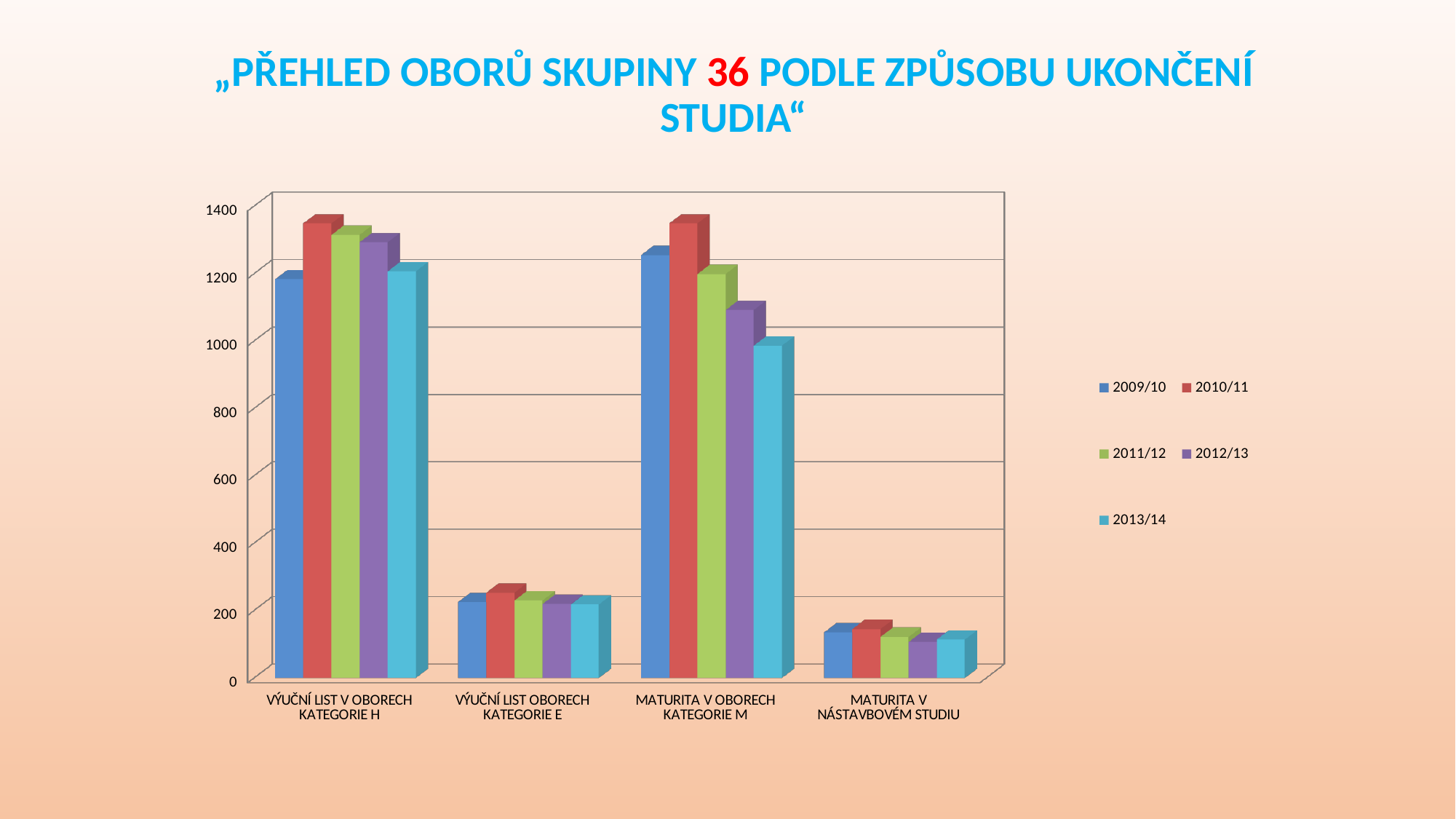
Within the category Maturita v oborech kategorie M, which series has the lowest value? 2013/14 Which category has the lowest values across all series? Maturita v nástavbovém studiu Is the value for 2012/13 in Maturita v oborech kategorie M greater or less than 1000? greater Is the value for 2010/11 in Výuční list v oborech kategorie H greater or less than 1200? greater How many series does the legend list? 5 Which series is shown in red in the legend? 2010/11 Within Maturita v oborech kategorie M, do the values rise or fall from 2010/11 to 2013/14? fall Within the category Maturita v oborech kategorie M, which series has the highest value? 2010/11 What kind of chart is shown on the slide? bar chart Is the value for 2011/12 in Maturita v nástavbovém studiu greater or less than 200? less For 2013/14, which is larger: Výuční list v oborech kategorie H or Maturita v oborech kategorie M? Výuční list v oborech kategorie H How many categories are shown on the x axis of the chart? 4